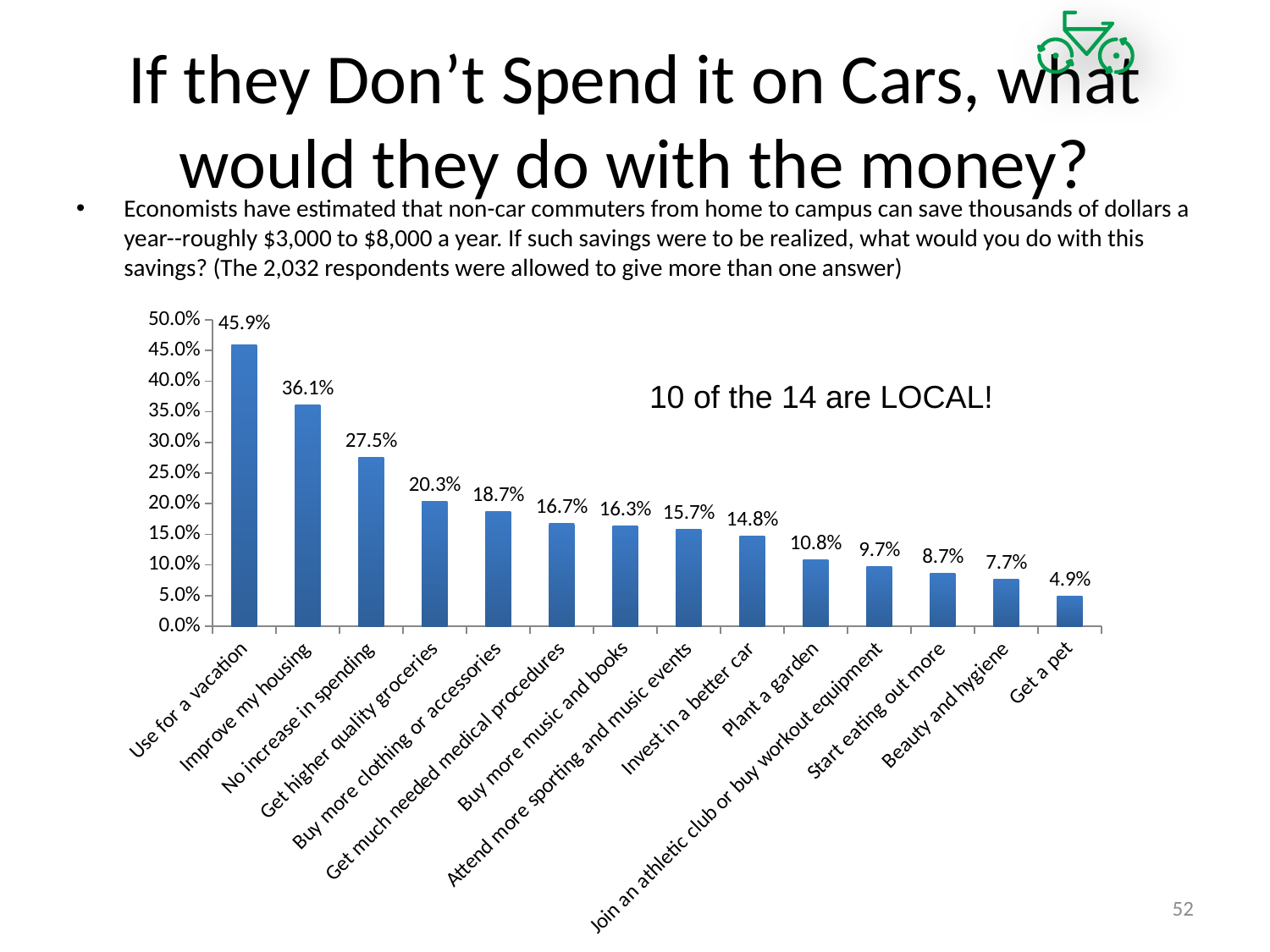
What is the value for "Invest in a better car"? 14.8% What is the difference between "Get higher quality groceries" and "Get a pet"? 15.4% Which category has the highest value? Use for a vacation How many categories are shown in the chart? 14 What kind of chart is shown on the slide? bar chart Do the values rise or fall from left to right along the x axis? fall What is the difference between "Use for a vacation" and "Improve my housing"? 9.8% What is the value for "Plant a garden"? 10.8% Is the value for "Start eating out more" greater or less than 10.0%? less Which is larger, "No increase in spending" or "Buy more clothing or accessories"? No increase in spending What percentage of respondents said they would use the savings for a vacation? 45.9% Which category has the lowest value? Get a pet